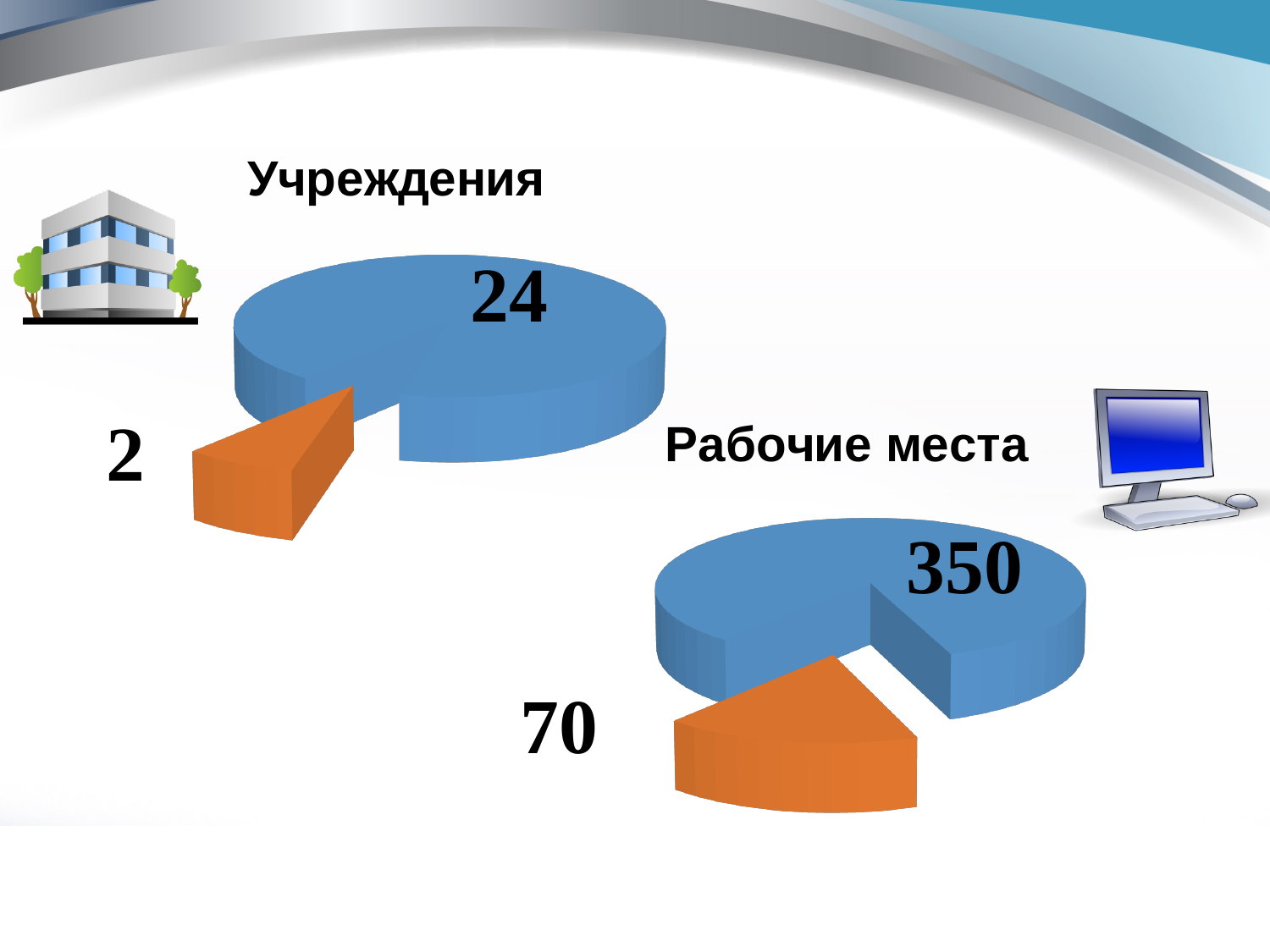
How many slices does the chart titled "Рабочие места" have? 2 What kind of chart is the chart titled "Учреждения"? pie chart In the chart titled "Рабочие места", what value is shown on the orange slice? 70 In the chart titled "Рабочие места", what value is shown on the blue slice? 350 In the chart titled "Учреждения", what value is shown on the blue slice? 24 In the chart titled "Учреждения", which slice has the larger value, the blue one or the orange one? the blue one In the chart titled "Учреждения", what value is shown on the orange slice? 2 What kind of chart is the chart titled "Рабочие места"? pie chart In the chart titled "Учреждения", what is the difference between the blue slice value and the orange slice value? 22 In the chart titled "Рабочие места", what is the difference between the blue slice value and the orange slice value? 280 In the chart titled "Рабочие места", which slice has the smaller value, the blue one or the orange one? the orange one What is the total of the two slice values in the chart titled "Рабочие места"? 420